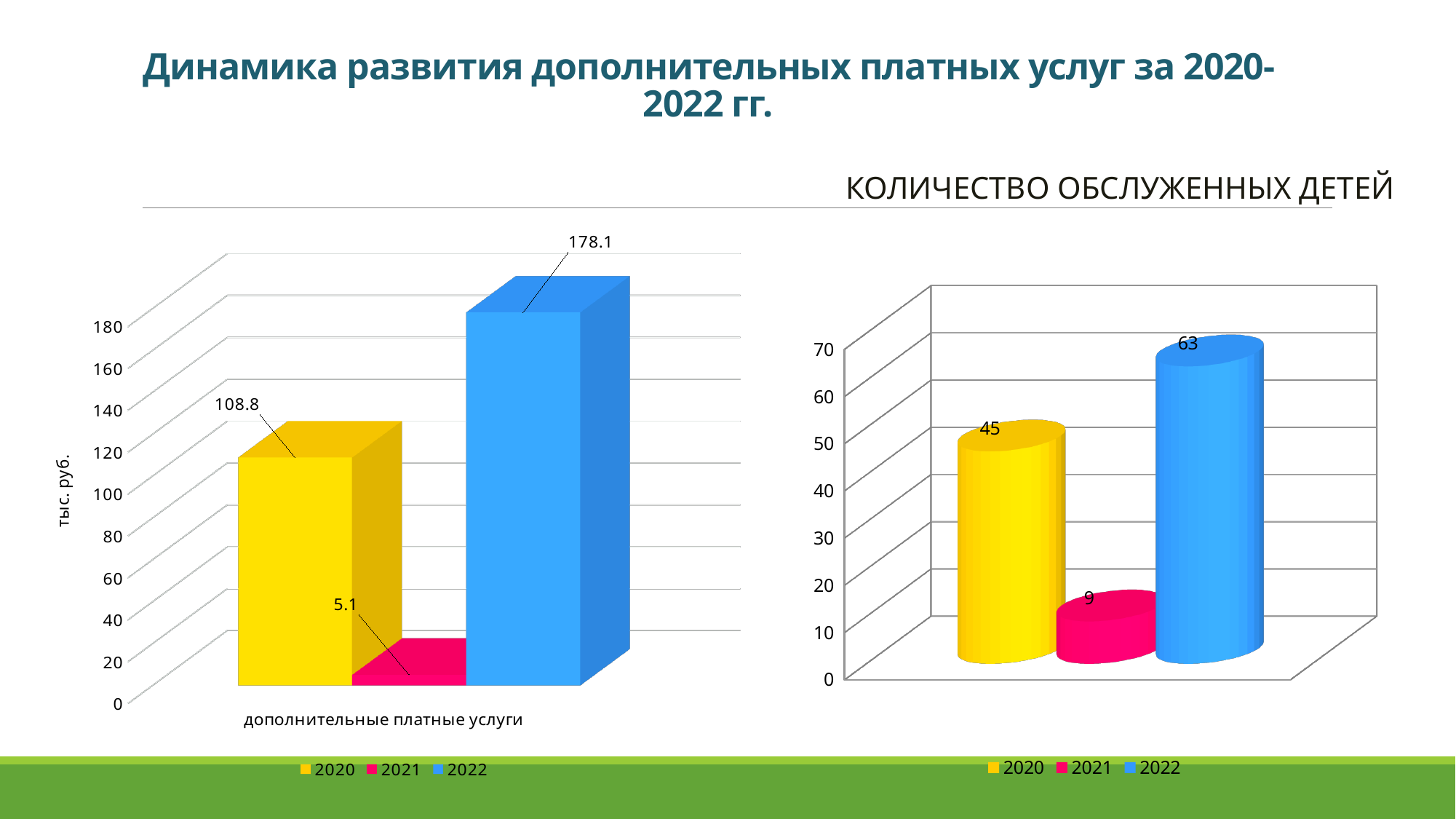
In the left chart, what unit is shown on the vertical axis? тыс. руб. In the chart titled 'КОЛИЧЕСТВО ОБСЛУЖЕННЫХ ДЕТЕЙ', what is the difference between the 2022 and 2021 values? 54 In the left chart, what is the difference between the 2022 and 2020 values? 69.3 In the chart titled 'КОЛИЧЕСТВО ОБСЛУЖЕННЫХ ДЕТЕЙ', what is the value for 2022? 63 In the left chart, what is the value for 2021? 5.1 How many series does the legend of the right chart list? 3 What kind of chart is the left chart? bar chart In the left chart, what is the value for 2022? 178.1 In the left chart, which year has the highest value? 2022 In the chart titled 'КОЛИЧЕСТВО ОБСЛУЖЕННЫХ ДЕТЕЙ', what is the value for 2020? 45 In the chart titled 'КОЛИЧЕСТВО ОБСЛУЖЕННЫХ ДЕТЕЙ', which is larger, the value for 2020 or the value for 2022? 2022 In the chart titled 'КОЛИЧЕСТВО ОБСЛУЖЕННЫХ ДЕТЕЙ', which year has the lowest value? 2021